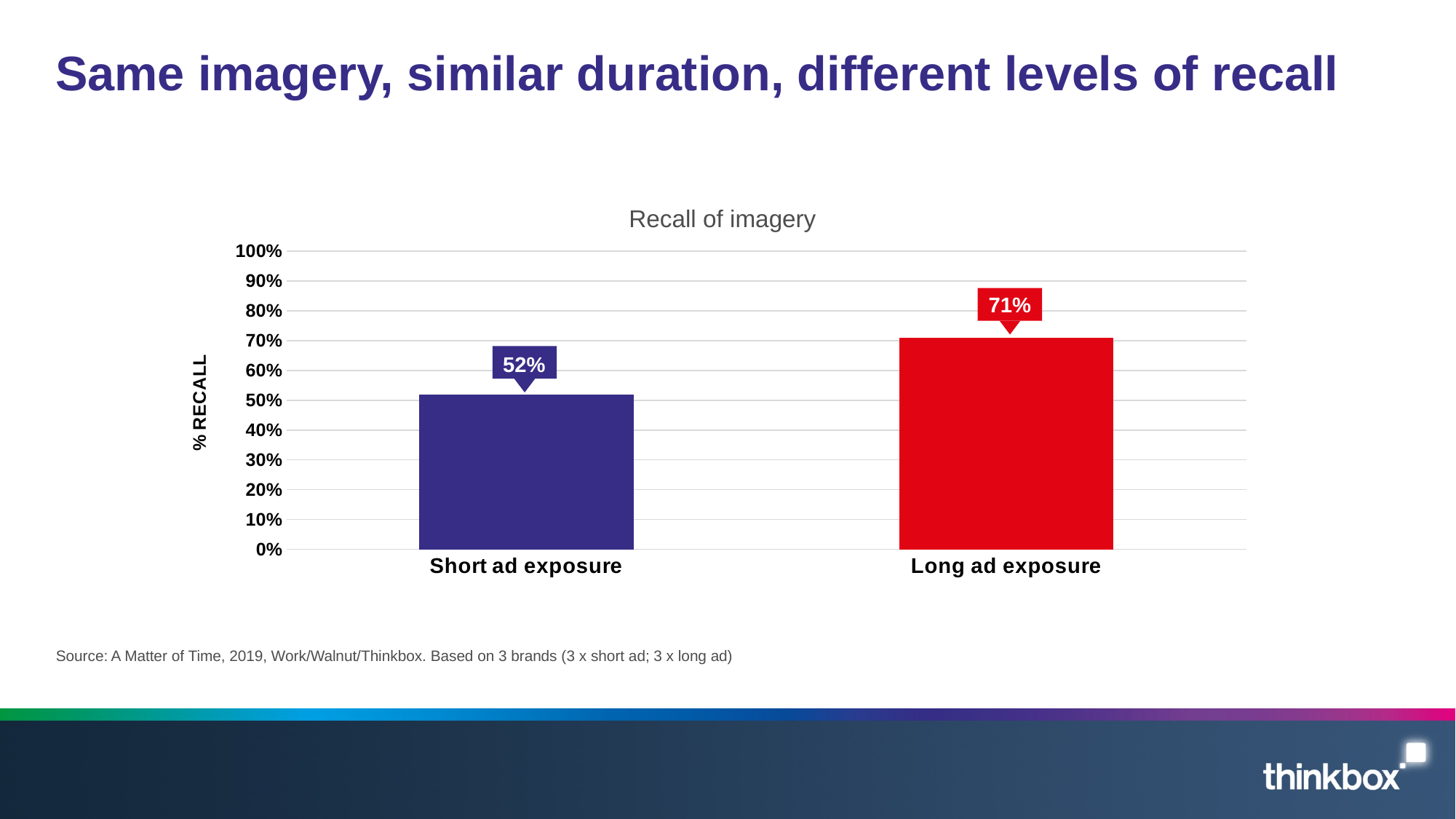
Which category has the lowest recall of imagery? Short ad exposure Is the value for Long ad exposure greater or less than 60%? greater Which category has the highest recall of imagery? Long ad exposure Which has a higher recall of imagery, Short ad exposure or Long ad exposure? Long ad exposure What is the recall of imagery for Short ad exposure? 52% What is the difference in recall between Long ad exposure and Short ad exposure? 19% What is the recall of imagery for Long ad exposure? 71% What is the title of the chart? Recall of imagery What is the label on the vertical axis of the chart? % RECALL What kind of chart is shown on the slide? Bar chart How many categories are shown on the chart? 2 Is the value for Short ad exposure greater or less than 60%? less